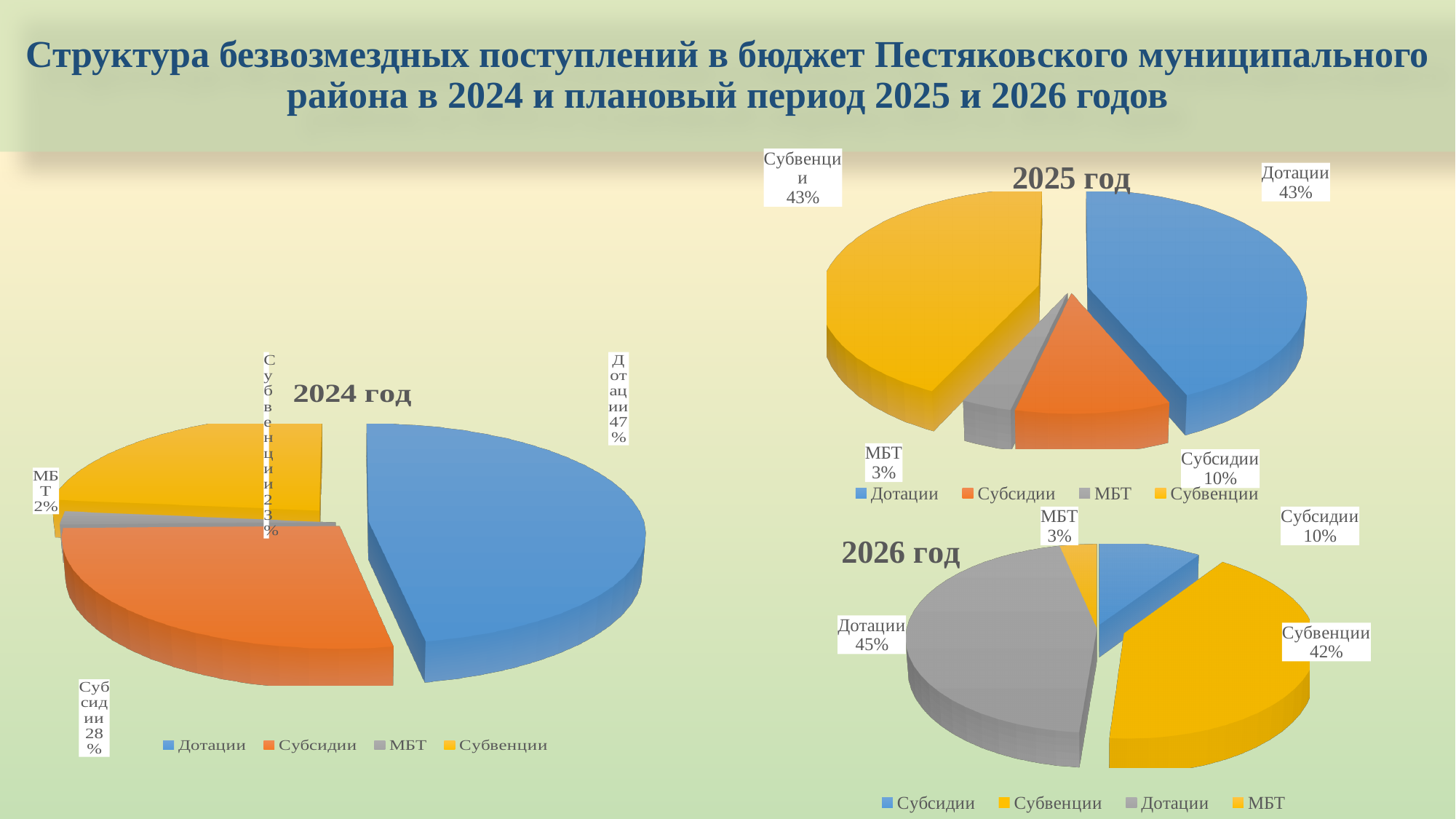
In the "2026 год" chart, what share does Субвенции have? 42% In the "2026 год" chart, which category has the largest share? Дотации In the "2026 год" chart, what is the difference between the shares of Дотации and Субвенции? 3 percentage points In the "2025 год" chart, which is larger, Субсидии or МБТ? Субсидии In the "2024 год" chart, what is the difference between the shares of Дотации and Субвенции? 24 percentage points In the "2025 год" chart, what share does МБТ have? 3% How many categories does the "2026 год" chart show? 4 In the "2024 год" chart, which category has the smallest share? МБТ In the "2024 год" chart, what share does Дотации have? 47% In the "2024 год" chart, what share does Субсидии have? 28% In the "2025 год" chart, what share does Субсидии have? 10% What type of chart is used for "2025 год"? Pie chart